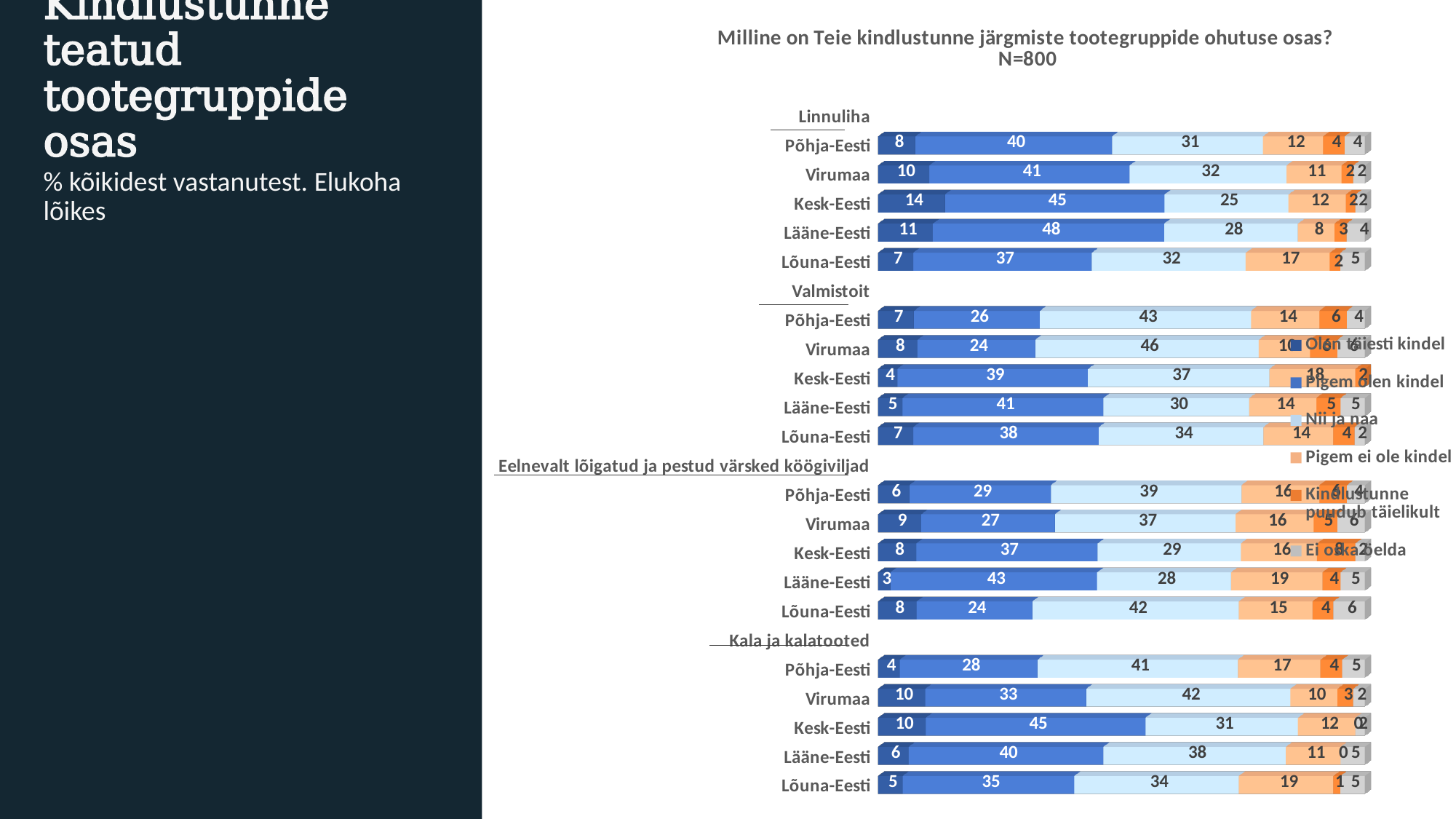
How many series does the legend list? 6 What is the total of the Linnuliha Põhja-Eesti bar across all segments? 99 What kind of chart is shown on the slide? Stacked bar chart In the Linnuliha group, which region has the highest 'Olen täiesti kindel' value? Kesk-Eesti In the Kala ja kalatooted group, what is the difference between the 'Pigem olen kindel' values for Kesk-Eesti and Põhja-Eesti? 17 How many bars (region rows) are plotted in the chart in total? 20 What is the N value stated in the chart title? N=800 In the Linnuliha group, what is the 'Pigem olen kindel' value for Lääne-Eesti? 48 In the Valmistoit group, which is larger: the 'Nii ja naa' value for Virumaa or for Lääne-Eesti? Virumaa In the Valmistoit group, what is the 'Olen täiesti kindel' value for Kesk-Eesti? 4 In the Eelnevalt lõigatud ja pestud värsked köögiviljad group, which region has the lowest 'Olen täiesti kindel' value? Lääne-Eesti In the Kala ja kalatooted group, what is the 'Nii ja naa' value for Virumaa? 42